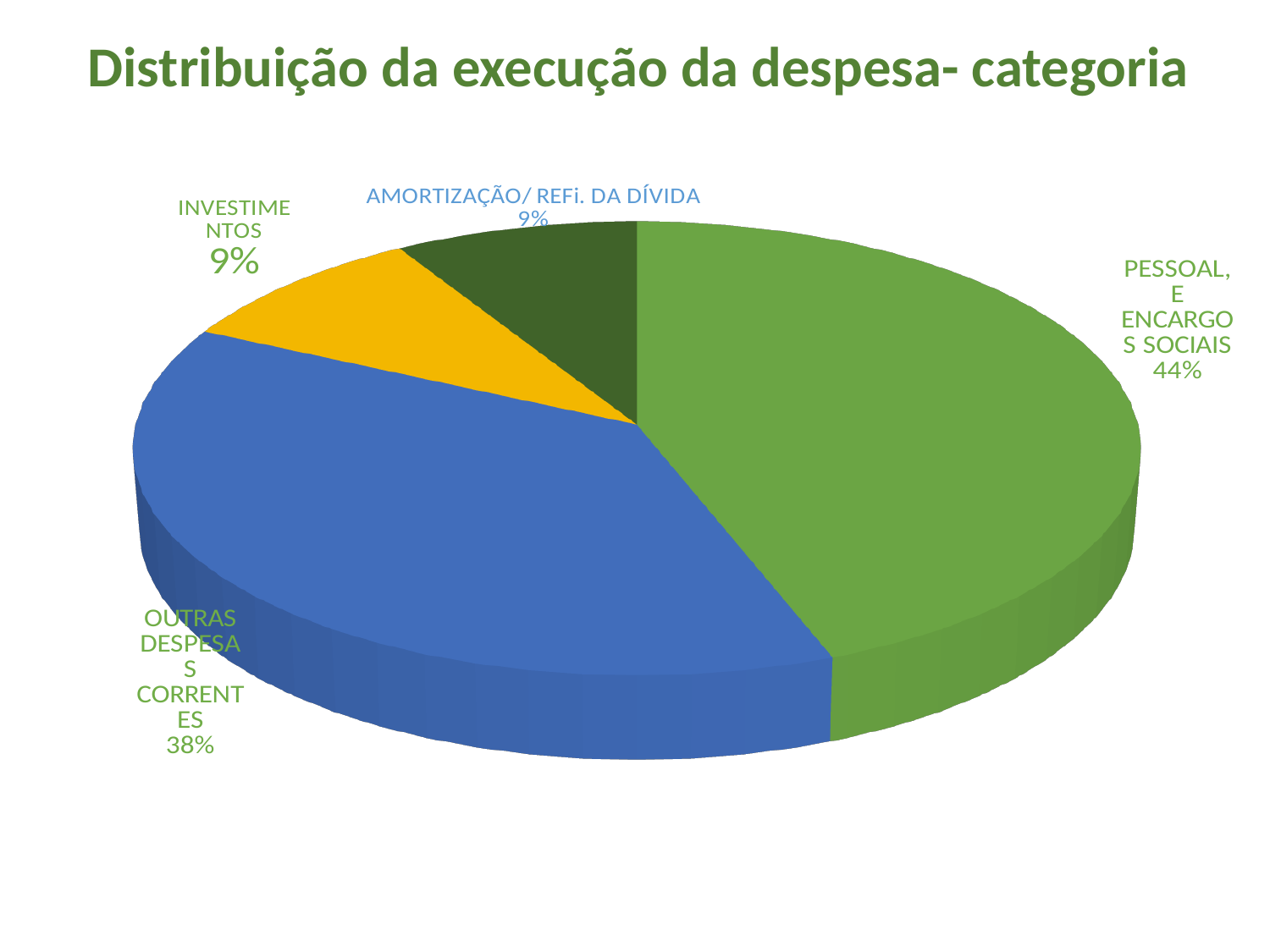
What is the difference in percentage points between PESSOAL E ENCARGOS SOCIAIS and OUTRAS DESPESAS CORRENTES? 6 percentage points Which category has the largest share of the pie? PESSOAL E ENCARGOS SOCIAIS What share of the pie does PESSOAL E ENCARGOS SOCIAIS represent? 44% What is the title of the chart on the slide? Distribuição da execução da despesa- categoria Which is larger, the share for OUTRAS DESPESAS CORRENTES or the share for INVESTIMENTOS? OUTRAS DESPESAS CORRENTES What percentage is shown for AMORTIZAÇÃO/ REFi. DA DÍVIDA? 9% What percentage is shown for OUTRAS DESPESAS CORRENTES? 38% What percentage is shown for INVESTIMENTOS? 9% How many categories are shown in the pie chart? 4 Is the share for OUTRAS DESPESAS CORRENTES greater or less than 40%? less What colour is the slice for INVESTIMENTOS? Yellow What kind of chart is shown on the slide? Pie chart